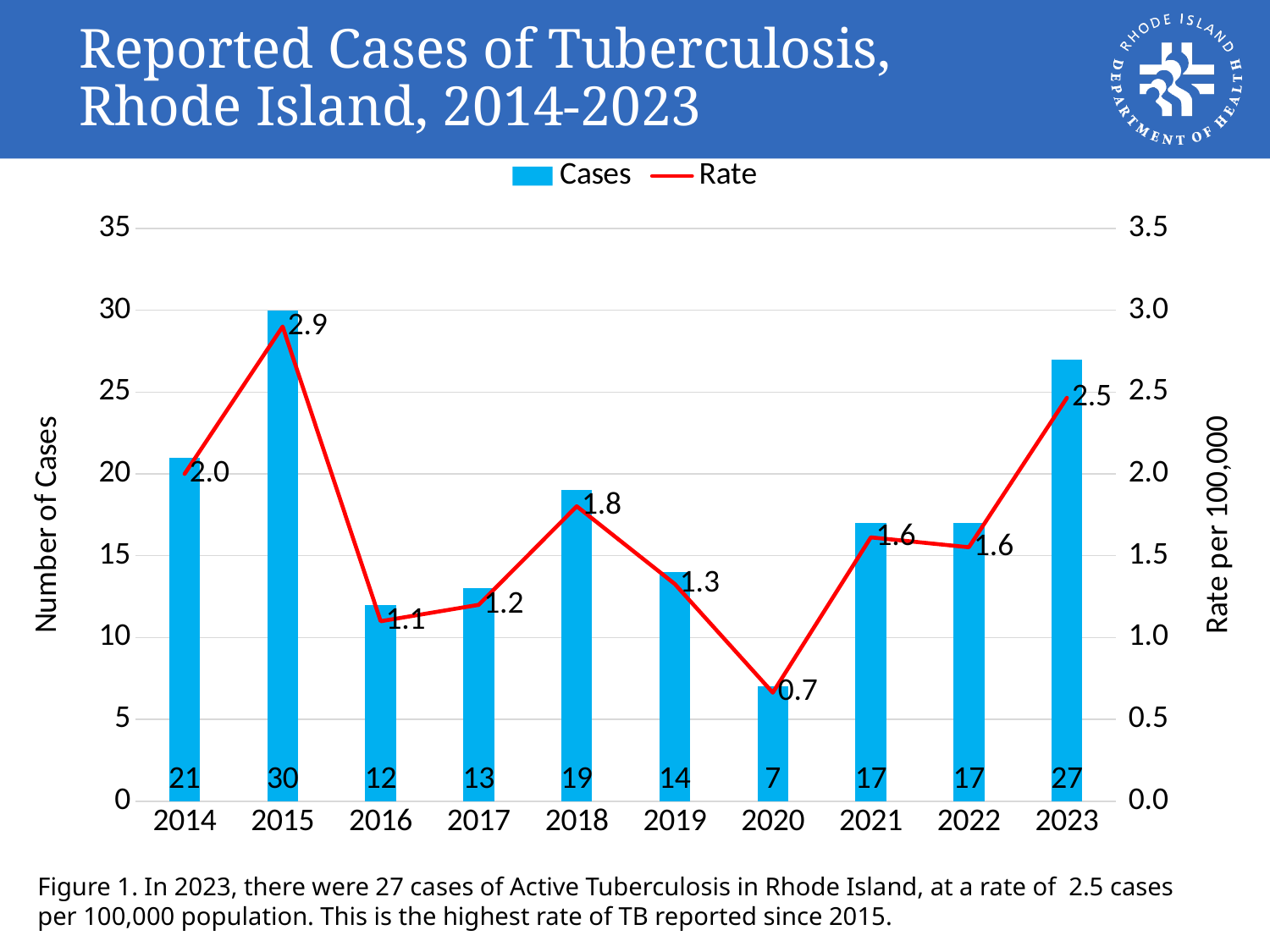
How many tuberculosis cases were reported in 2015? 30 Which year had the highest number of reported cases? 2015 What is the label of the right-hand vertical axis? Rate per 100,000 How many years are shown on the x axis? 10 Did the rate per 100,000 rise or fall from 2020 to 2023? Rise What is the difference in the number of cases between 2023 and 2020? 20 What was the rate per 100,000 in 2020? 0.7 Which year had more reported cases, 2018 or 2019? 2018 Which year had the lowest rate per 100,000? 2020 How many series does the legend list? 2 What kind of chart is used to show the number of cases? Bar chart What is the difference in rate per 100,000 between 2015 and 2016? 1.8